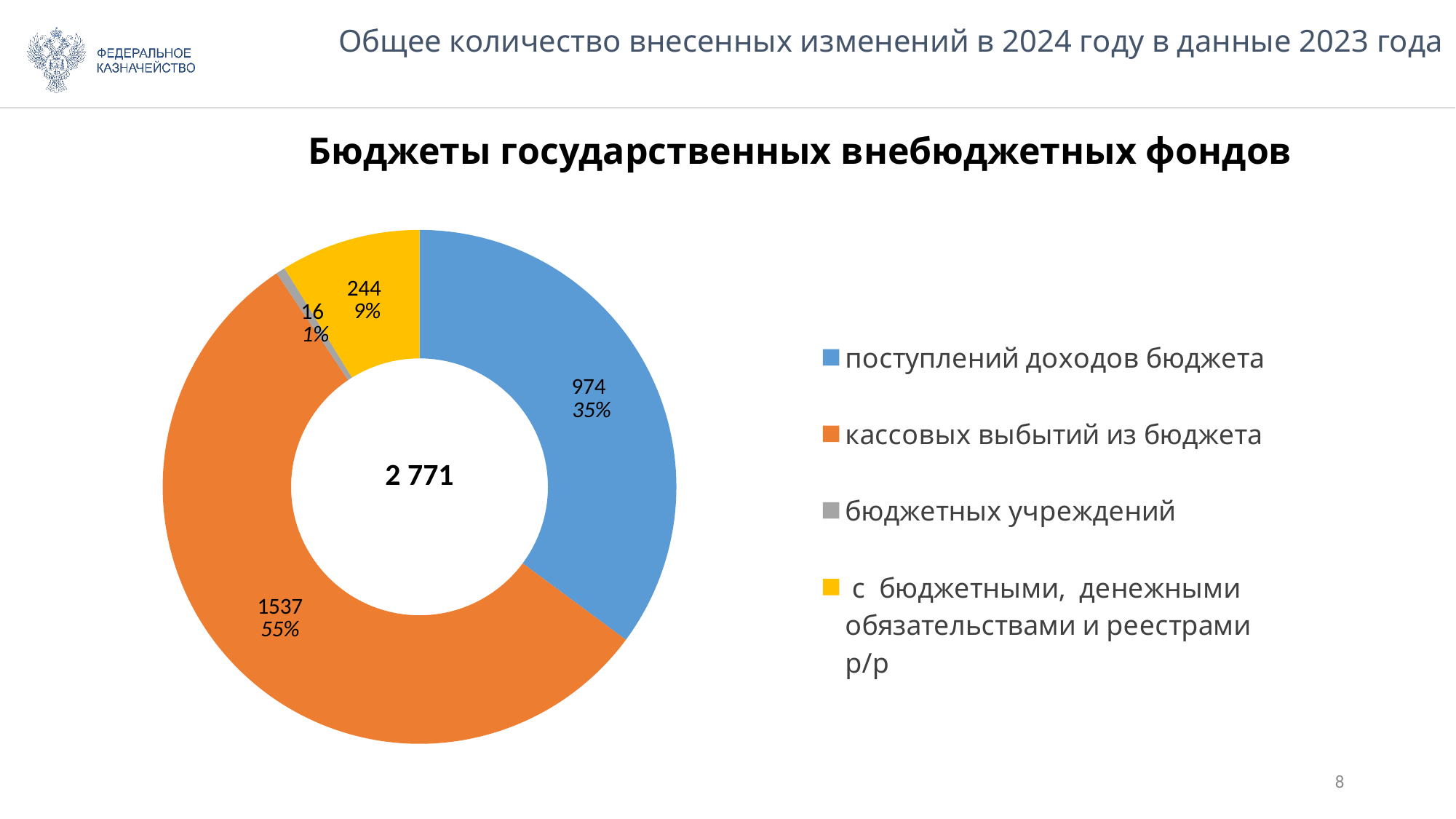
What value is shown for "кассовых выбытий из бюджета"? 1537 What share of the chart does "поступлений доходов бюджета" represent? 35% How many categories does the chart show? 4 What value is shown for "бюджетных учреждений"? 16 What share of the chart does "с бюджетными, денежными обязательствами и реестрами р/р" represent? 9% Which is larger: the value for "поступлений доходов бюджета" or for "с бюджетными, денежными обязательствами и реестрами р/р"? поступлений доходов бюджета Which category has the largest slice? кассовых выбытий из бюджета What value is shown for "поступлений доходов бюджета"? 974 Which category has the smallest slice? бюджетных учреждений What total is shown in the centre of the chart? 2 771 What is the difference between the values for "кассовых выбытий из бюджета" and "поступлений доходов бюджета"? 563 What value is shown for "с бюджетными, денежными обязательствами и реестрами р/р"? 244